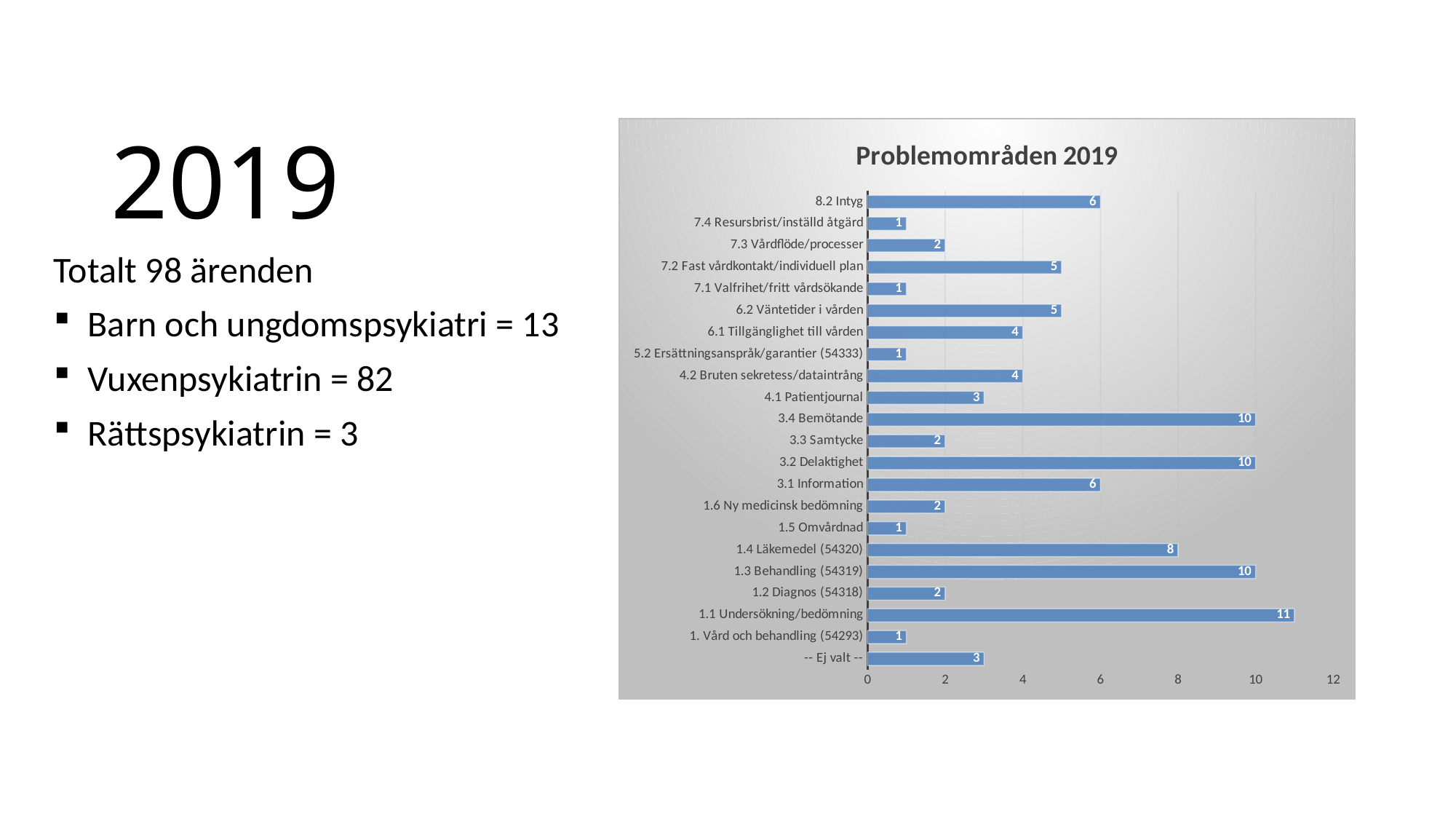
What is the title of the chart? Problemområden 2019 What is the difference between the values for 1.1 Undersökning/bedömning and 1.4 Läkemedel (54320)? 3 What is the value for 6.2 Väntetider i vården? 5 Is the value for 1.3 Behandling (54319) greater or less than 8? greater Which category has the highest value? 1.1 Undersökning/bedömning Which is larger, the value for 7.2 Fast vårdkontakt/individuell plan or the value for 7.3 Vårdflöde/processer? 7.2 Fast vårdkontakt/individuell plan What is the value for 1.4 Läkemedel (54320)? 8 What is the value for 4.1 Patientjournal? 3 How many categories are shown in the chart? 22 What is the value for 8.2 Intyg? 6 What kind of chart is shown on the slide? bar chart What is the difference between the values for 3.4 Bemötande and 3.3 Samtycke? 8